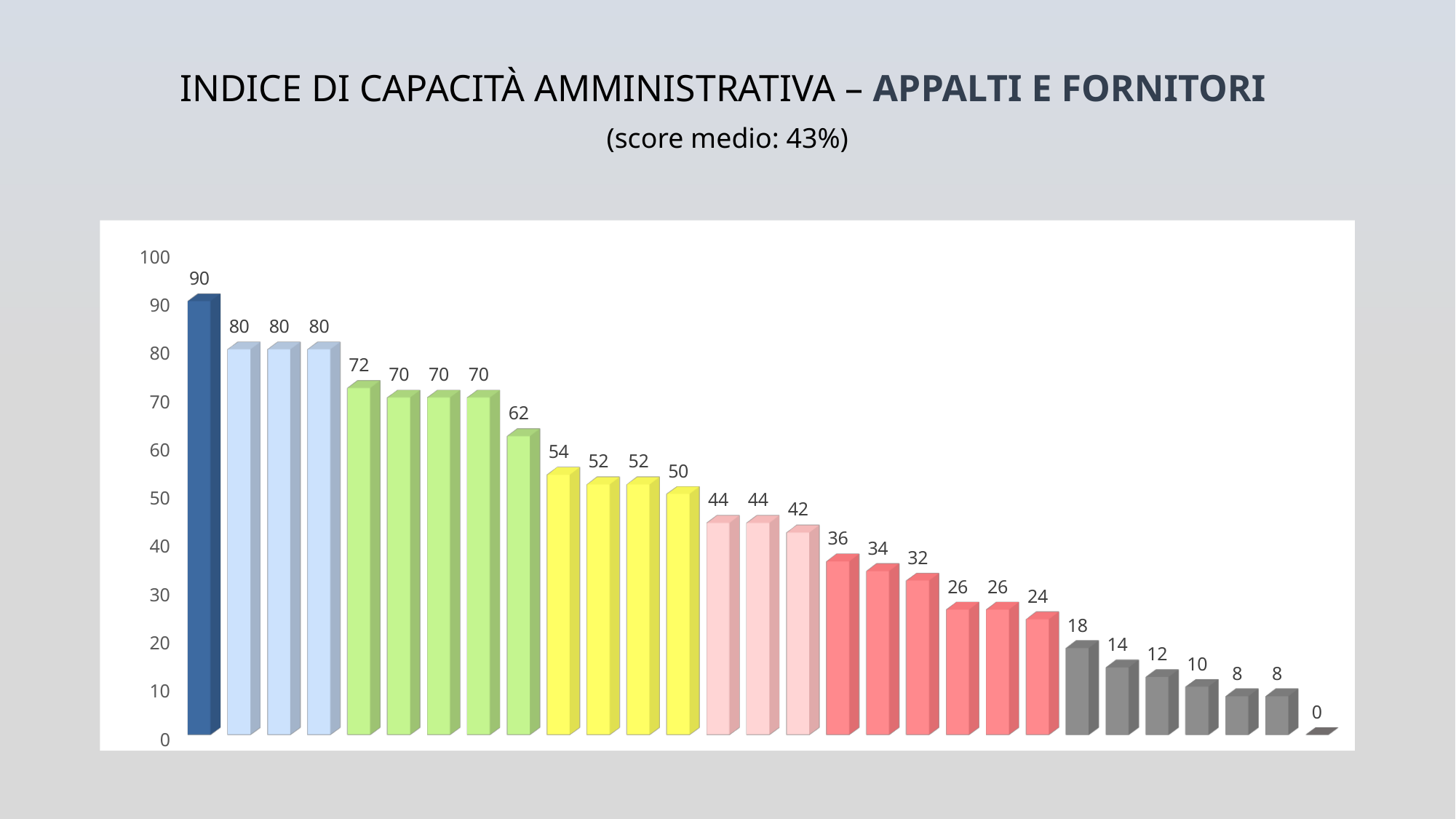
What is the value of the last (rightmost) bar? 0 What is the value of the first (leftmost, dark blue) bar? 90 What is the highest value shown on the vertical axis of the chart? 100 How many bars have a value of 80? 3 How many bars are plotted in the chart? 29 What is the difference between the first bar (90) and the second bar (80)? 10 What kind of chart is shown on the slide? bar chart Which is larger, the value of the first green bar (72) or the value of the first yellow bar (54)? 72 What is the value of the tallest bar in the chart? 90 Do the bar values rise or fall from left to right across the chart? fall What average score (score medio) is stated in the slide subtitle? 43% What is the value of the lowest bar in the chart? 0